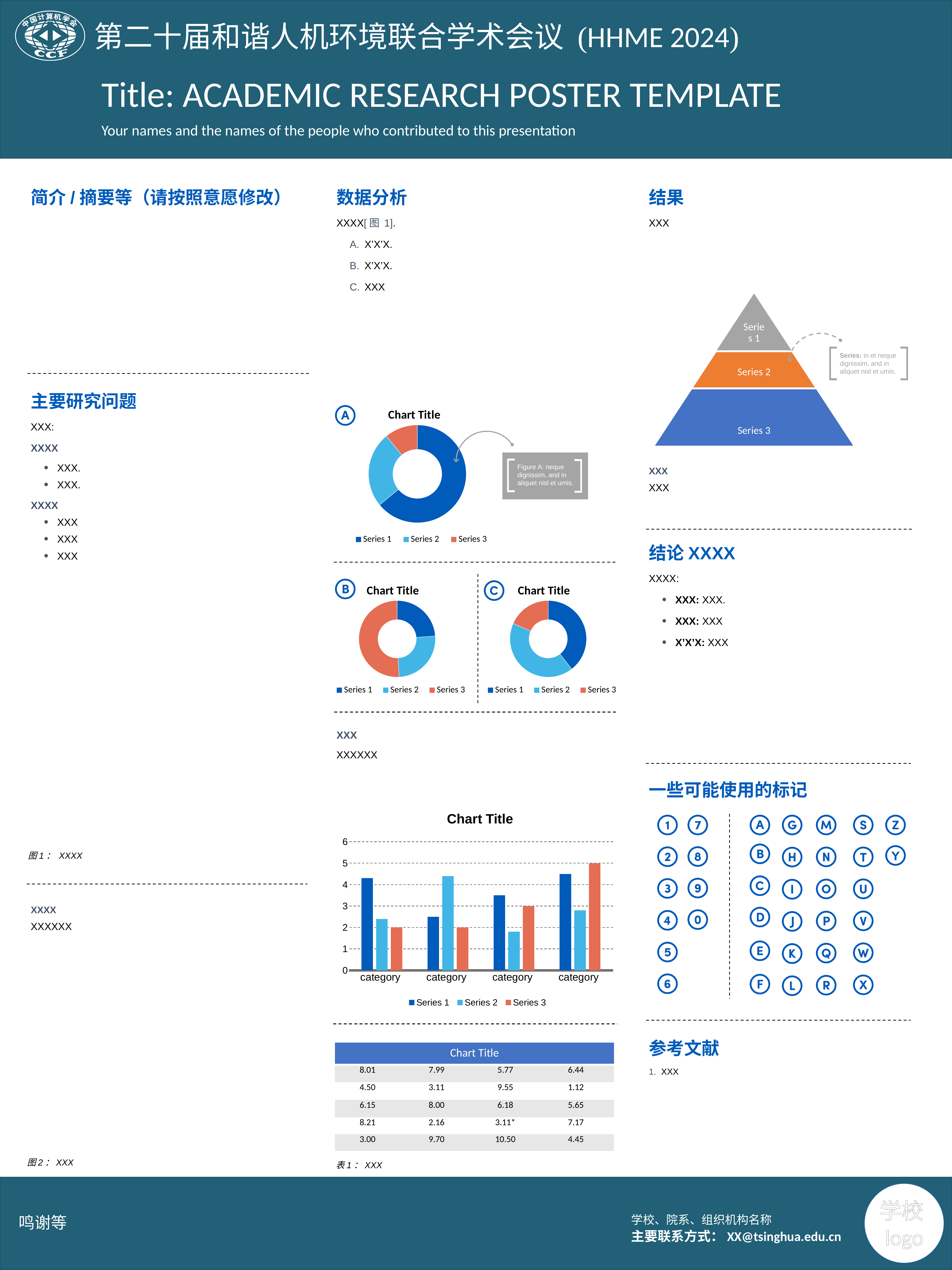
How many category groups are shown on the x axis of the bar chart? 4 How many series does the legend of the bar chart list? 3 In the bar chart, is the value of Series 1 in the leftmost category group greater or less than 4? greater In the doughnut chart labelled A, which series has the largest slice? Series 1 In the bar chart, is the value of Series 2 in the third category group from the left greater or less than 2? less In the doughnut chart labelled B, which series has the largest slice? Series 3 How many series does the legend of the doughnut chart labelled C list? 3 What kind of chart is the chart in the lower part of the middle column with the x-axis labels 'category'? Bar chart In the bar chart, which series has the tallest bar in the rightmost category group? Series 3 In the doughnut chart labelled C, which series has the smallest slice? Series 3 What kind of chart is the chart labelled A at the top of the middle column? Doughnut chart What is the title shown above the bar chart? Chart Title